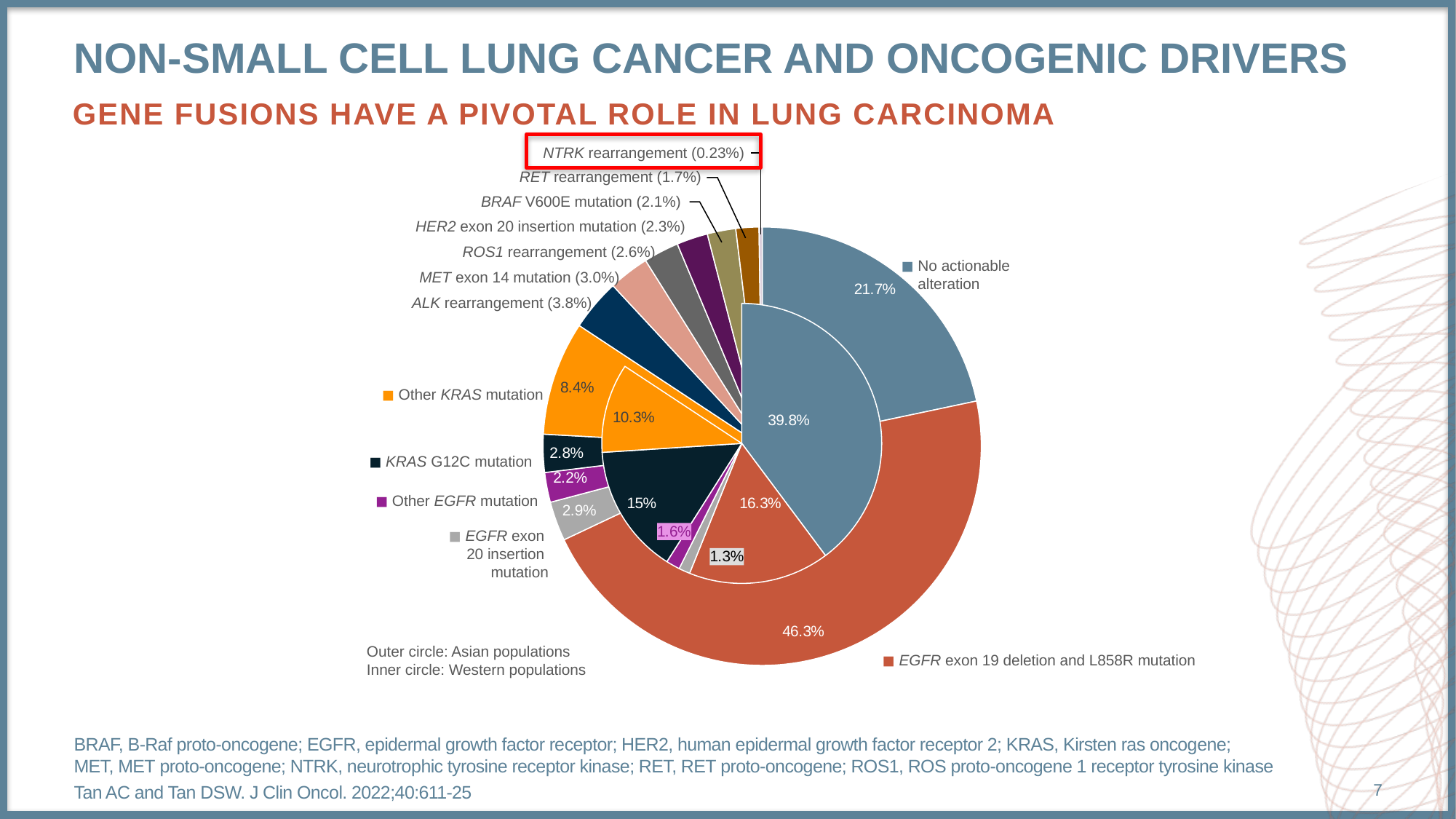
Is the Other KRAS mutation share larger in the inner circle (10.3%) or the outer circle (8.4%)? Inner circle What percentage is shown for NTRK rearrangement? 0.23% What is the difference between the No actionable alteration share in the inner circle (39.8%) and in the outer circle (21.7%)? 18.1% In the outer circle (Asian populations), what percentage is labelled for EGFR exon 19 deletion and L858R mutation? 46.3% In the inner circle (Western populations), what percentage is labelled for No actionable alteration? 39.8% What percentage is shown for ALK rearrangement? 3.8% Which category has the largest slice in the outer circle (Asian populations)? EGFR exon 19 deletion and L858R mutation In the outer circle (Asian populations), what percentage is labelled for No actionable alteration? 21.7% Which labelled category has the smallest percentage on the chart? NTRK rearrangement What percentage is shown for RET rearrangement? 1.7% What kind of chart is shown on the slide? Pie chart What percentage is shown for MET exon 14 mutation? 3.0%